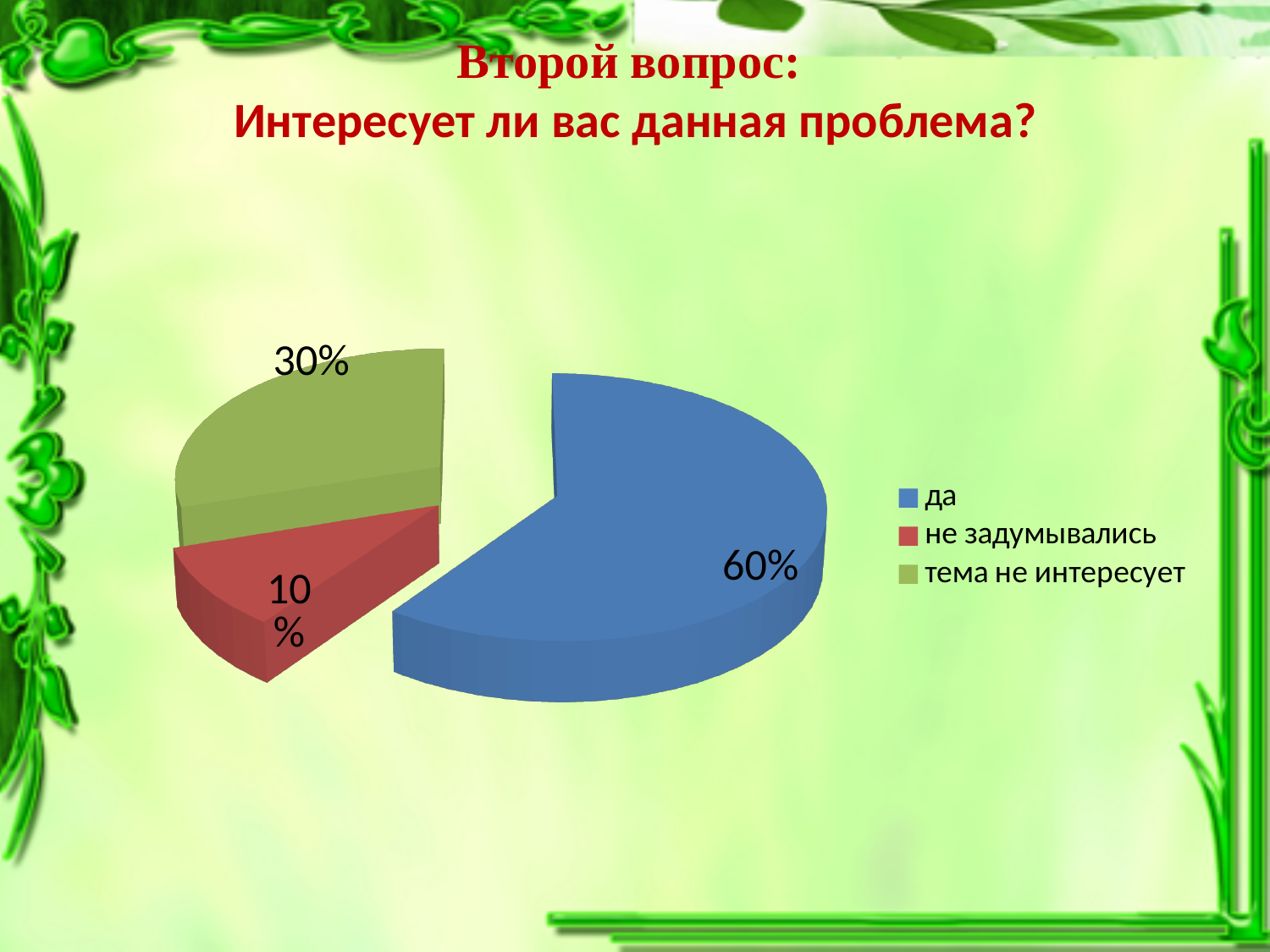
What colour is the slice for "да"? blue What is the difference between the shares for "да" and "тема не интересует"? 30% What share of the pie does "тема не интересует" have? 30% Which category has the largest slice of the pie? да What is the difference between the shares for "тема не интересует" and "не задумывались"? 20% What share of the pie does "да" have? 60% What is the title of the slide above the chart? Второй вопрос: Интересует ли вас данная проблема? How many categories does the pie chart have? 3 Which is larger, the share for "тема не интересует" or the share for "не задумывались"? тема не интересует Which category has the smallest slice of the pie? не задумывались What share of the pie does "не задумывались" have? 10% What kind of chart is shown on the slide? pie chart